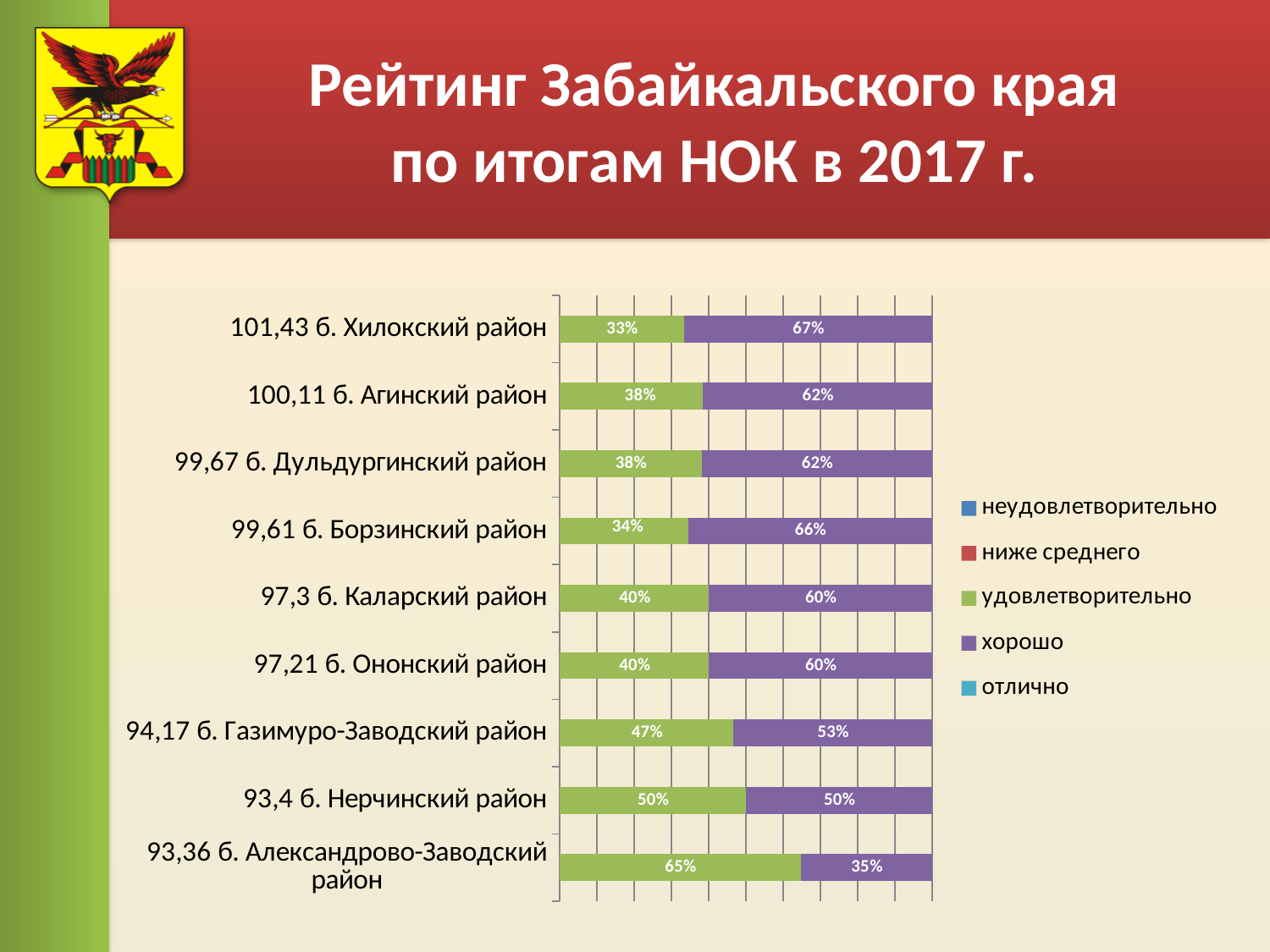
What kind of chart is shown on the slide? Stacked bar chart Which district has the lowest "хорошо" value? 93,36 б. Александрово-Заводский район Which legend entry is shown in purple? хорошо What is the difference between the "хорошо" and "удовлетворительно" values for 94,17 б. Газимуро-Заводский район? 6% Which district has the highest "хорошо" value? 101,43 б. Хилокский район How many series does the legend list? 5 What is the total of the stacked bar for 93,4 б. Нерчинский район? 100% What is the "удовлетворительно" value for 101,43 б. Хилокский район? 33% Which is larger for 97,3 б. Каларский район: the "удовлетворительно" value or the "хорошо" value? хорошо What is the "хорошо" value for 99,61 б. Борзинский район? 66% What is the "удовлетворительно" value for 93,36 б. Александрово-Заводский район? 65% How many districts (categories) are shown in the chart? 9